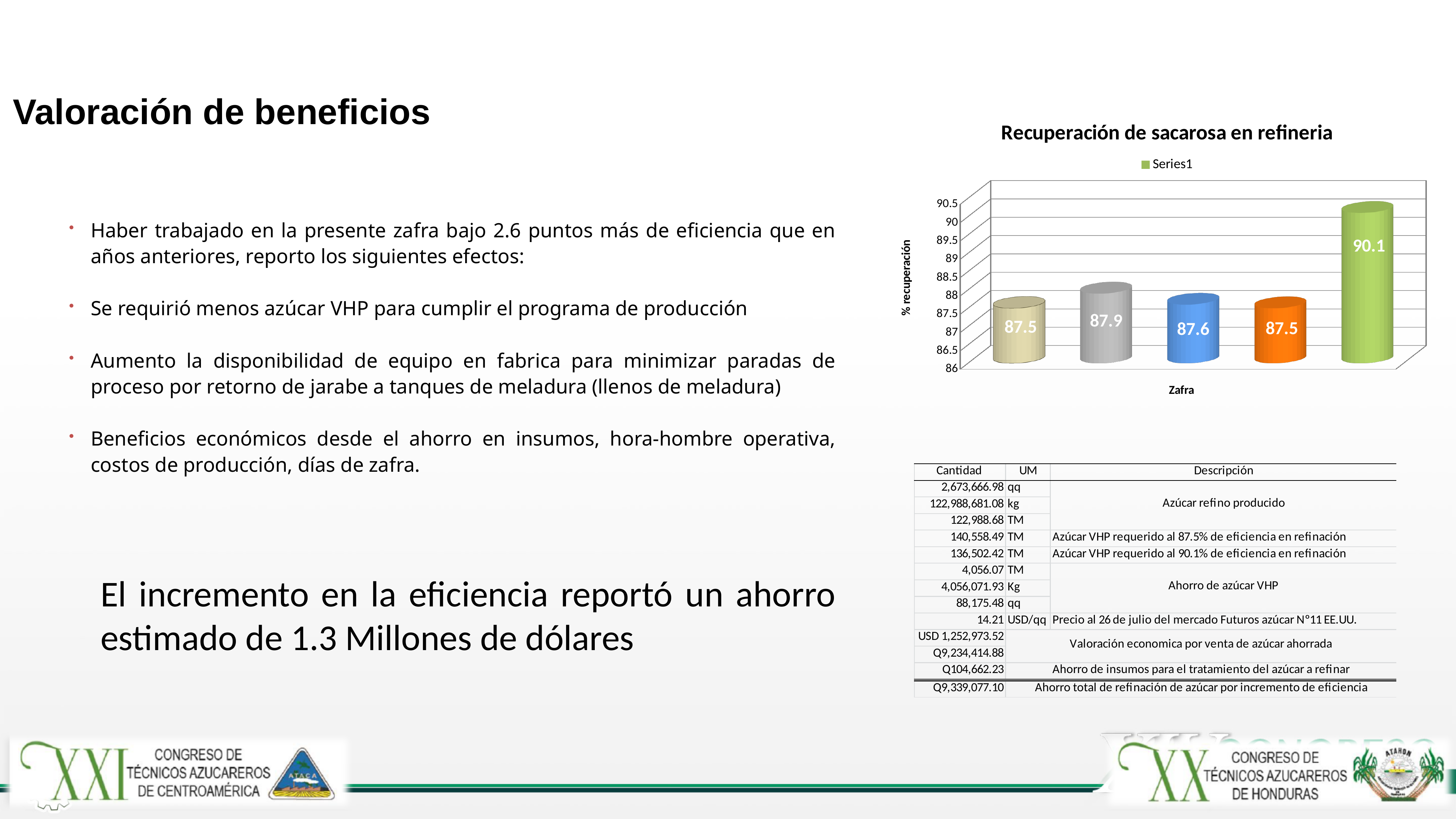
In the 'Recuperación de sacarosa en refineria' chart, what is the difference between the rightmost bar (90.1) and the leftmost bar (87.5)? 2.6 How many bars are plotted in the 'Recuperación de sacarosa en refineria' chart? 5 What is the lowest value shown in the 'Recuperación de sacarosa en refineria' chart? 87.5 What kind of chart is 'Recuperación de sacarosa en refineria'? bar chart What is the label of the vertical axis in the 'Recuperación de sacarosa en refineria' chart? % recuperación In the 'Recuperación de sacarosa en refineria' chart, which is larger: the grey bar or the blue bar? the grey bar (87.9) How many series does the legend of the 'Recuperación de sacarosa en refineria' chart list? 1 In the 'Recuperación de sacarosa en refineria' chart, what is the value of the blue bar? 87.6 In the 'Recuperación de sacarosa en refineria' chart, is the value of the rightmost bar greater or less than 89? greater In the 'Recuperación de sacarosa en refineria' chart, what is the value of the second bar from the left (grey)? 87.9 In the 'Recuperación de sacarosa en refineria' chart, what is the value of the rightmost (green) bar? 90.1 What is the highest value shown in the 'Recuperación de sacarosa en refineria' chart? 90.1